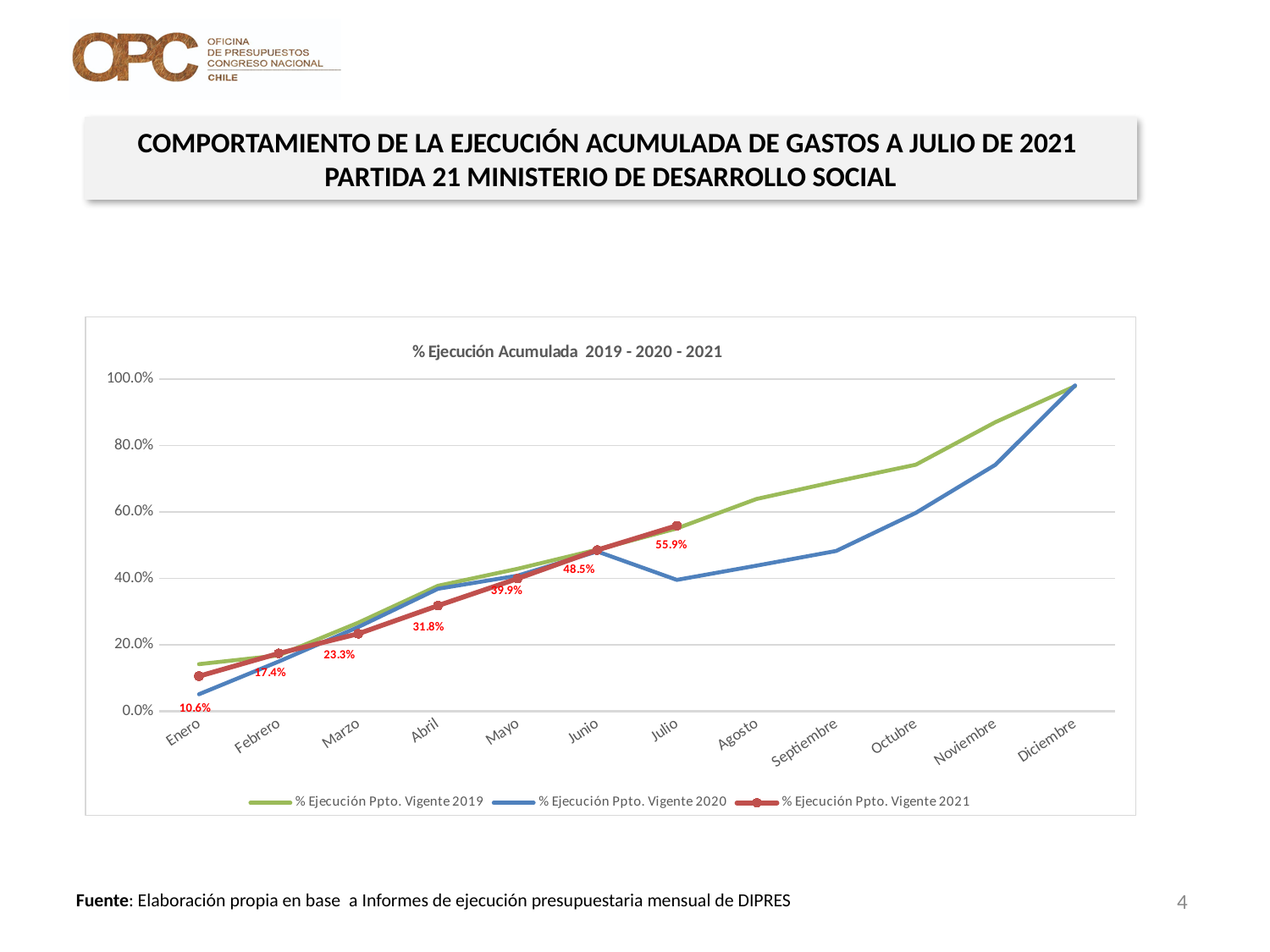
What type of chart is shown on the slide? line chart Is the value for % Ejecución Ppto. Vigente 2020 in Julio greater or less than 60.0%? less What is the title of the chart? % Ejecución Acumulada 2019 - 2020 - 2021 How many months are shown on the x axis? 12 In which month does the % Ejecución Ppto. Vigente 2021 series reach its highest value? Julio Does the % Ejecución Ppto. Vigente 2021 series rise or fall from Enero to Julio? rise Which series has the higher value in Octubre, 2019 or 2020? % Ejecución Ppto. Vigente 2019 How many series does the legend list? 3 What is the value for % Ejecución Ppto. Vigente 2021 in Abril? 31.8% What is the difference between the 2021 values for Julio and Junio? 7.4% What is the value for % Ejecución Ppto. Vigente 2021 in Enero? 10.6% What is the value for % Ejecución Ppto. Vigente 2021 in Julio? 55.9%